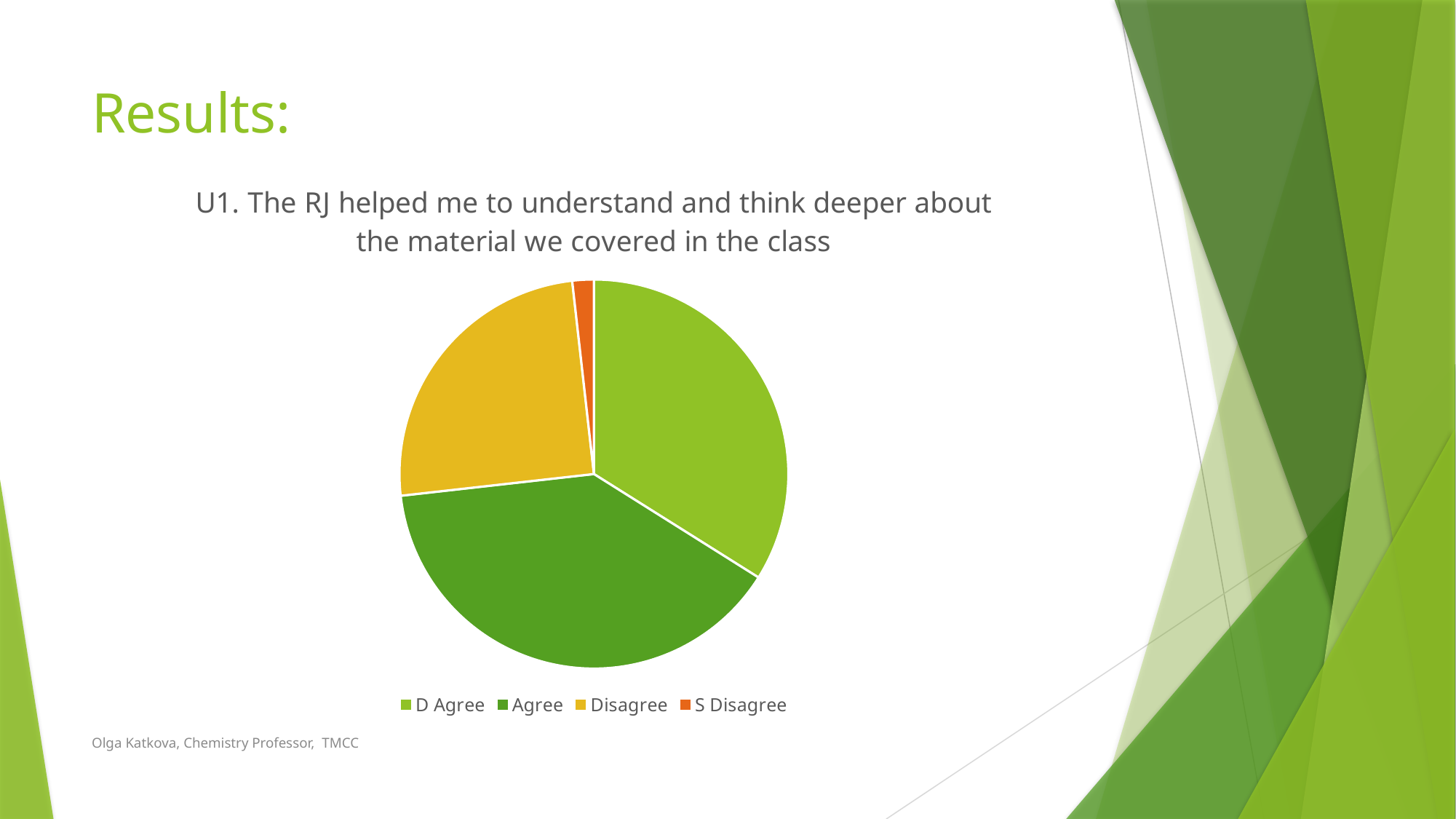
Which slice is larger, Disagree or S Disagree? Disagree Which slice is larger, Agree or S Disagree? Agree Which colour represents the Disagree slice in the pie chart? yellow What kind of chart is shown on the slide? pie chart How many slices does the pie chart have? 4 What is the title of the pie chart? U1. The RJ helped me to understand and think deeper about the material we covered in the class How many entries does the legend of the pie chart list? 4 Which category has the smallest slice in the pie chart? S Disagree Which slice is larger, Agree or Disagree? Agree